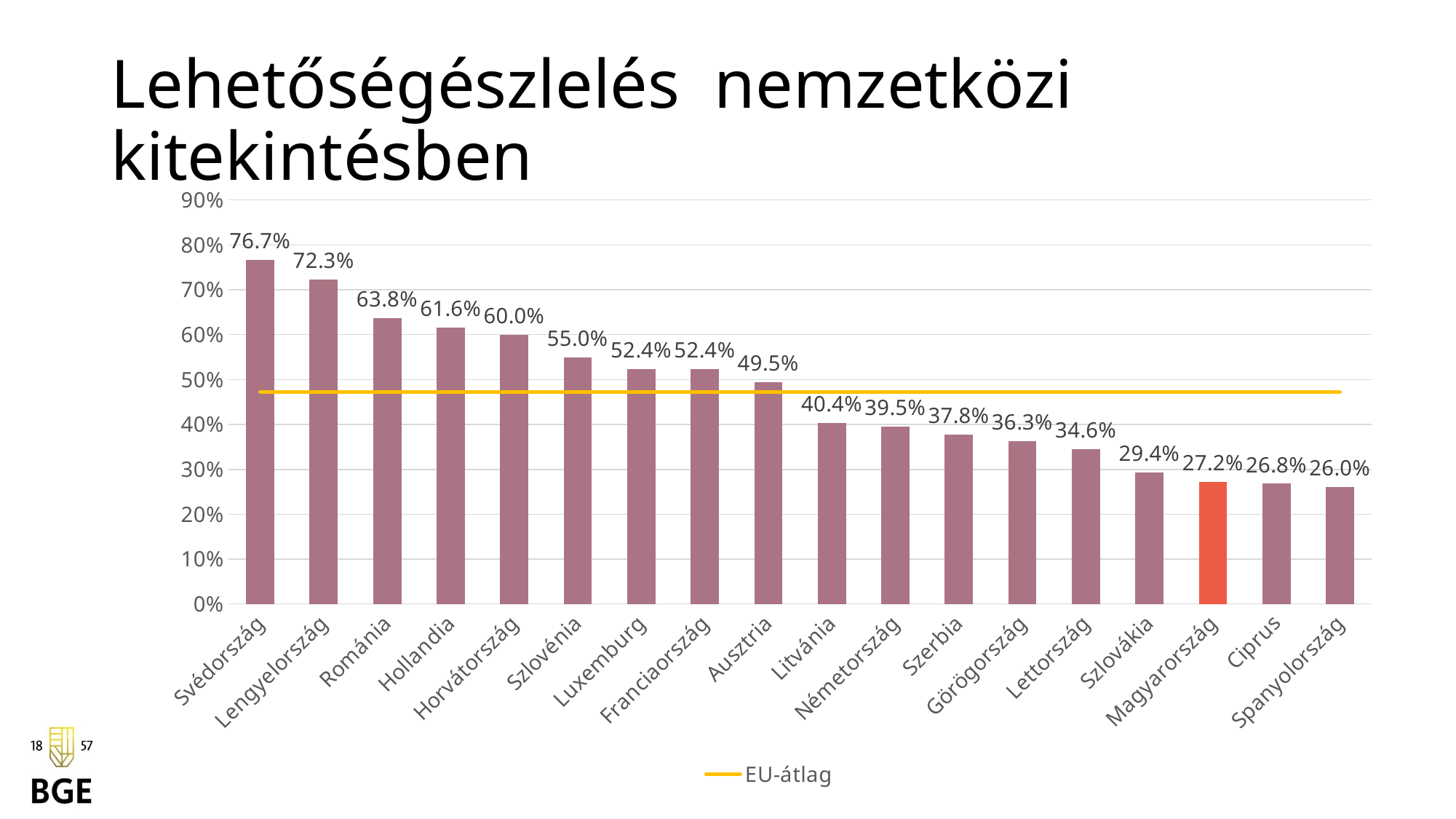
Which has a larger value, Románia or Litvánia? Románia How many entries does the legend list? 1 Which country has the lowest value? Spanyolország Do the bar values rise or fall from left to right along the x axis? fall What kind of chart is shown on the slide? combination bar and line chart (bars with an EU-átlag line) What is the value for Németország? 39.5% What is the value for Svédország? 76.7% How many countries are shown on the chart? 18 What is the value for Magyarország, the bar highlighted in orange? 27.2% Is the EU-átlag line greater or less than 50%? less What is the difference between the values for Svédország and Magyarország? 49.5 percentage points Which country has the highest value? Svédország